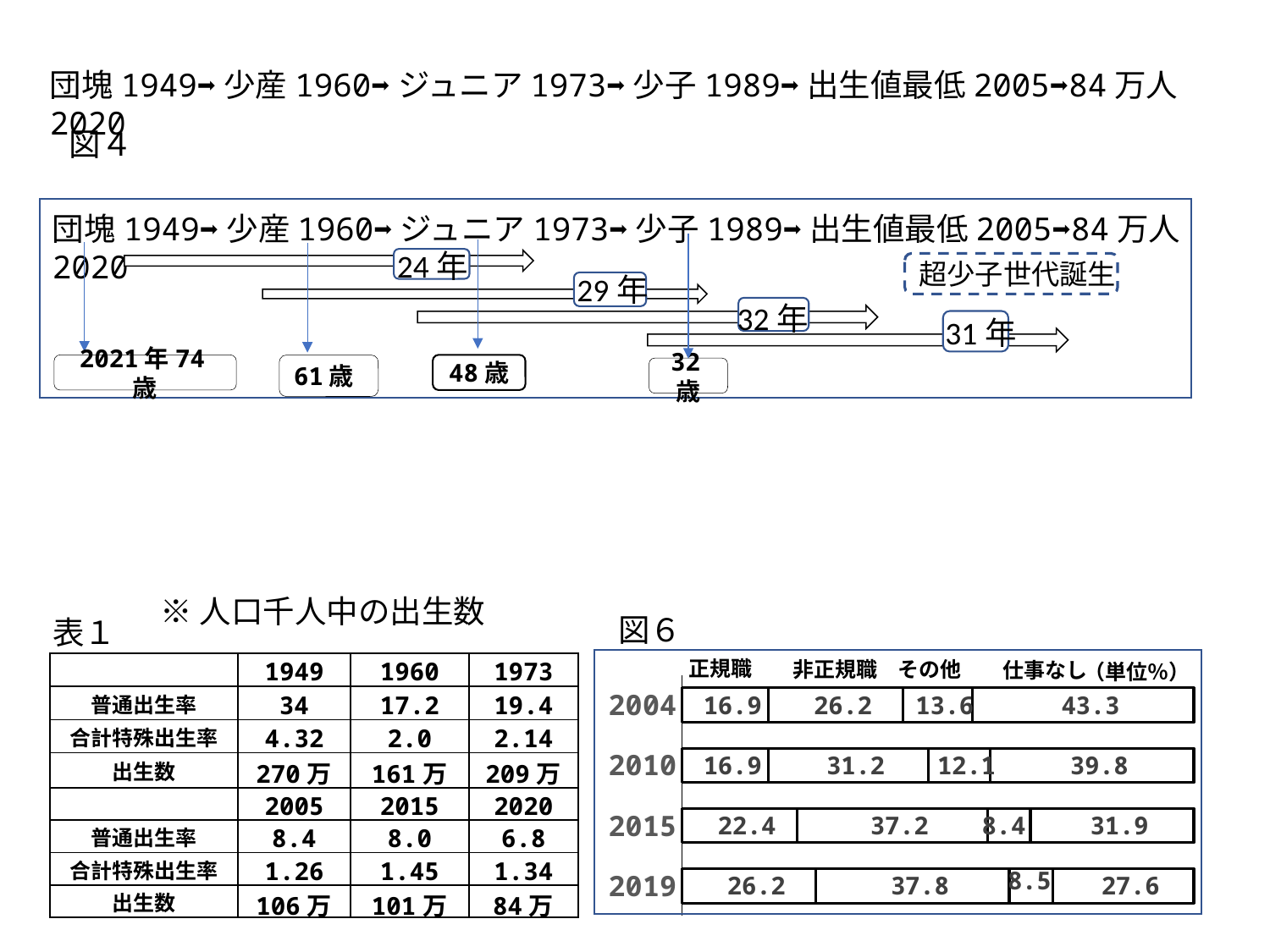
In 図6, what is the difference between the 仕事なし values for 2004 and 2019? 15.7 In 図6, for 2010, which is larger: 非正規職 or 仕事なし? 仕事なし In 図6, what is the value for 正規職 in 2019? 26.2 In 図6, does the value for 仕事なし rise or fall from 2004 to 2019? fall In 図6, which year has the highest value for 非正規職? 2019 In 図6, what unit are the values shown in? % In 図6, which year has the lowest value for 仕事なし? 2019 In 図6, how many years are plotted? 4 In 図6, what is the value for その他 in 2010? 12.1 In 図6, what is the value for 仕事なし in 2004? 43.3 What kind of chart is 図6? stacked bar chart In 図6, how many series does the legend list? 4